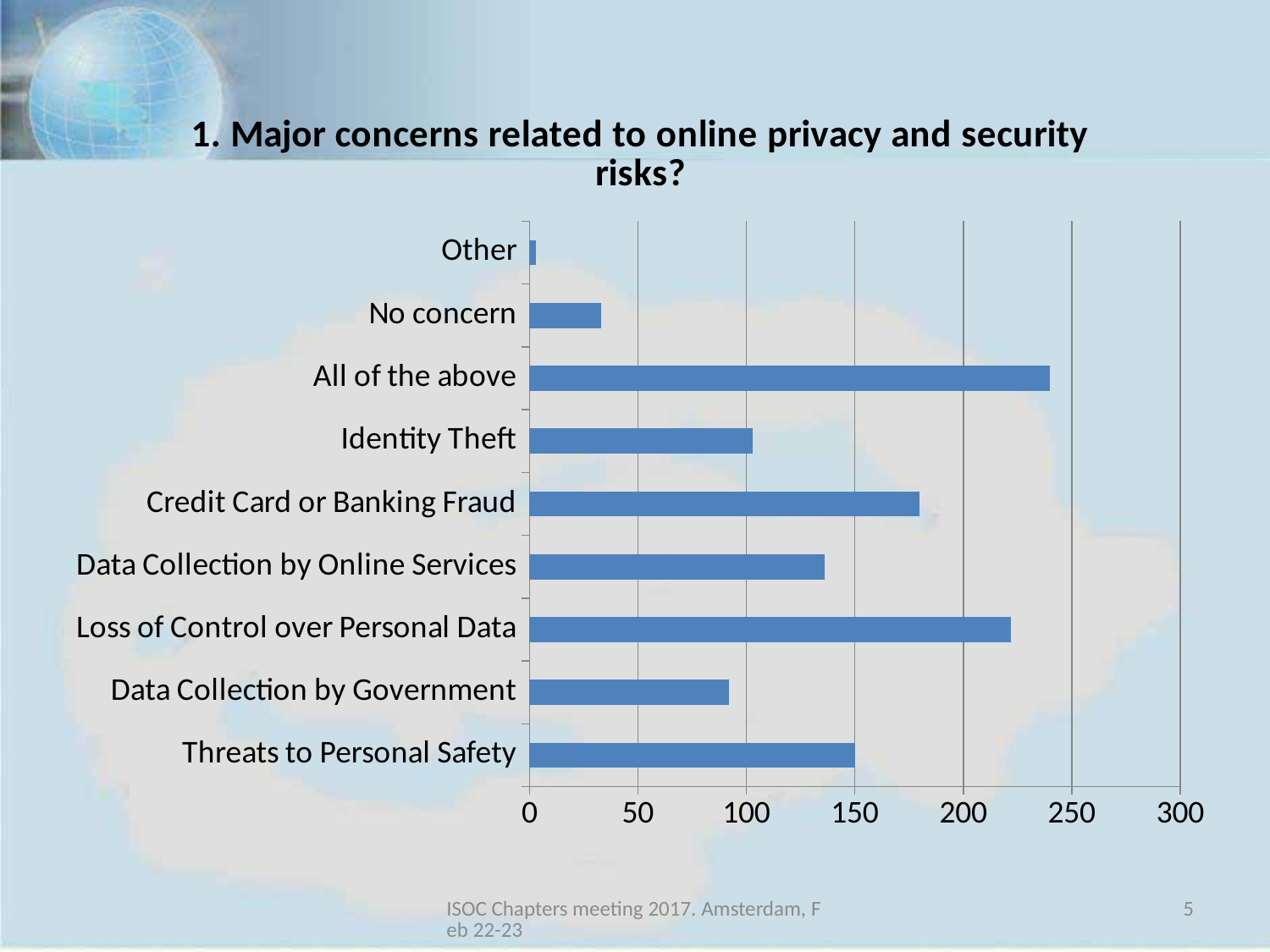
Is the value for No concern greater or less than 50? less What kind of chart is shown on the slide? bar chart Is the value for Data Collection by Government greater or less than 150? less Which category has the lowest value? Other What is the title of the chart? 1. Major concerns related to online privacy and security risks? Is the value for Credit Card or Banking Fraud greater or less than 150? greater Which is larger, the value for Credit Card or Banking Fraud or the value for Identity Theft? Credit Card or Banking Fraud Which category has the highest value? All of the above How many categories are shown on the chart? 9 Which is larger, the value for Data Collection by Online Services or the value for Loss of Control over Personal Data? Loss of Control over Personal Data